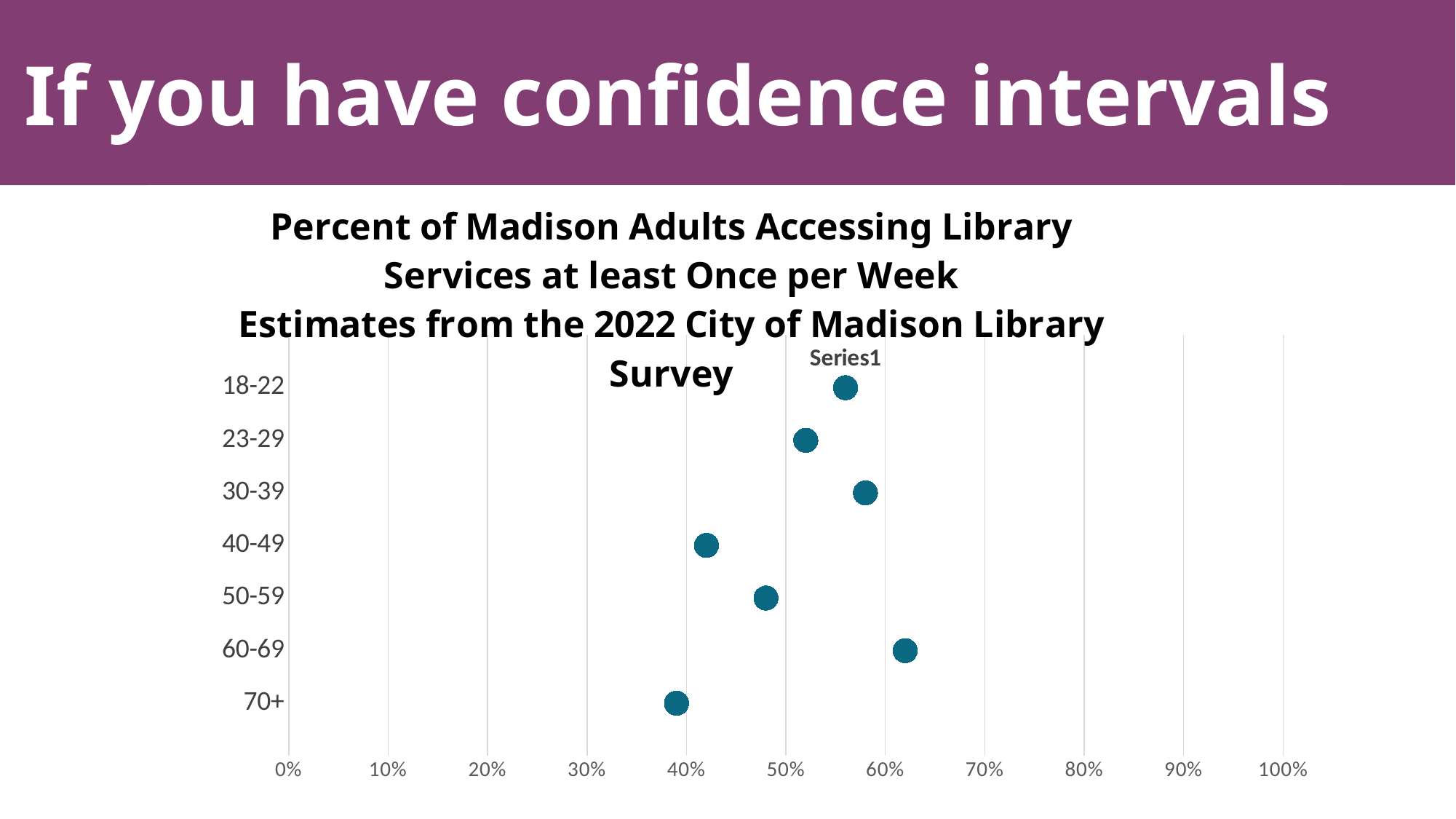
Which has the larger value, the 60-69 age group or the 40-49 age group? 60-69 Which age group has the highest percentage accessing library services at least once per week? 60-69 Which age group has the lowest percentage accessing library services at least once per week? 70+ Is the value for the 60-69 age group greater or less than 60%? greater Is the value for the 50-59 age group greater or less than 50%? less What kind of chart is shown on the slide? Dot plot (scatter chart) Is the value for the 18-22 age group greater or less than 50%? greater Which has the larger value, the 30-39 age group or the 50-59 age group? 30-39 How many age groups are plotted on the chart? 7